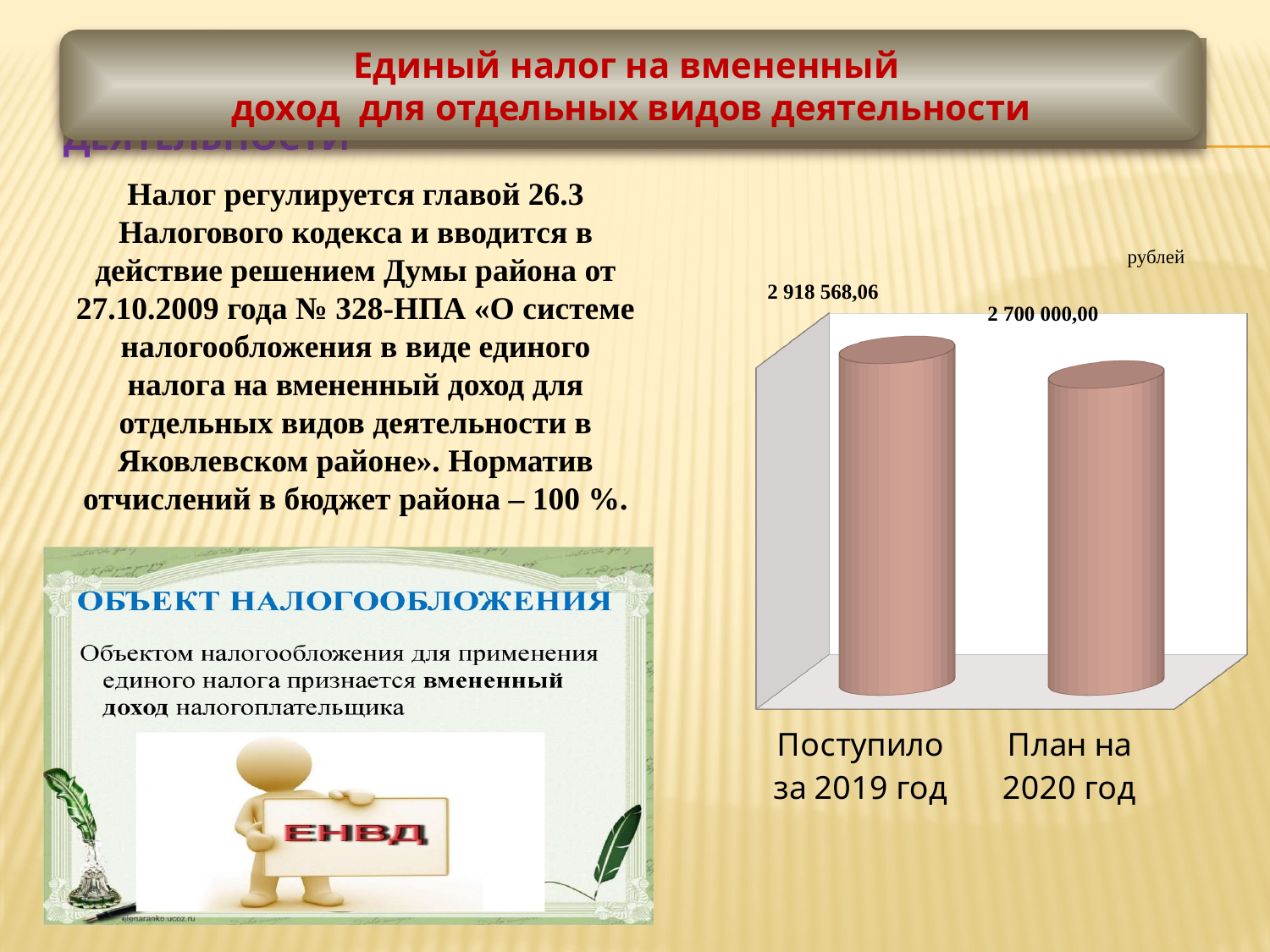
What kind of chart is shown on the slide? Bar chart What colour are the bars on the chart? Pink (salmon) Which is larger: the value for "Поступило за 2019 год" or the value for "План на 2020 год"? Поступило за 2019 год What is the value for "Поступило за 2019 год" on the chart? 2 918 568,06 How many categories are shown on the chart? 2 Do the values rise or fall from "Поступило за 2019 год" to "План на 2020 год"? Fall Which category has the lowest value on the chart? План на 2020 год What is the value for "План на 2020 год" on the chart? 2 700 000,00 Which category has the highest value on the chart? Поступило за 2019 год What unit label is shown above the chart? рублей What is the difference between the value for "Поступило за 2019 год" and the value for "План на 2020 год"? 218 568,06